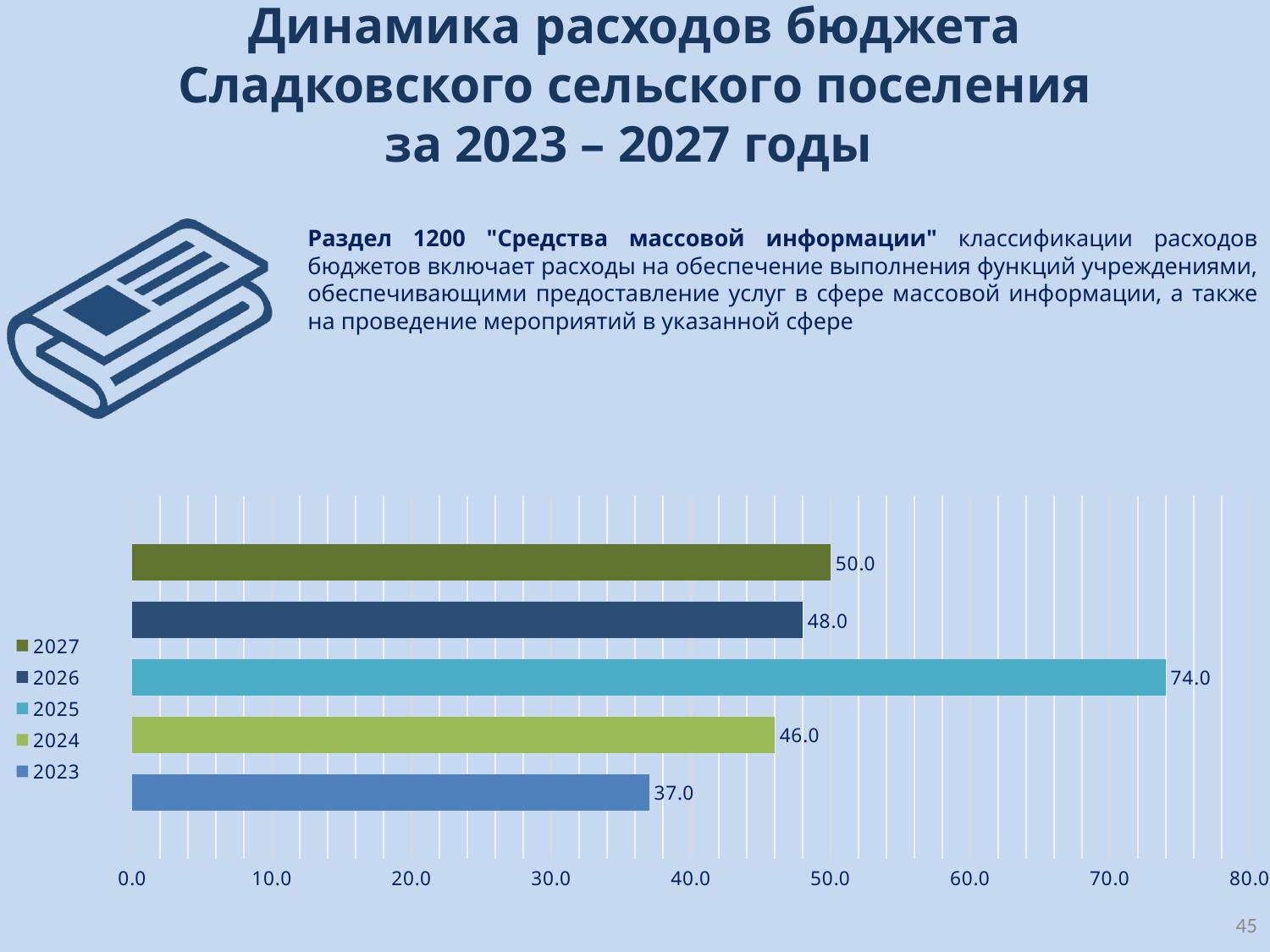
What is the difference between the values for 2027 and 2026? 2.0 What is the value for 2023? 37.0 How many bars are shown in the chart? 5 What kind of chart is shown on the slide? bar chart Is the value for 2026 greater or less than 40.0? greater What is the value for 2025? 74.0 What is the value for 2027? 50.0 Which year has the highest value? 2025 How many entries does the legend list? 5 Which is larger, the value for 2024 or the value for 2023? 2024 What is the difference between the values for 2025 and 2024? 28.0 Which year has the lowest value? 2023